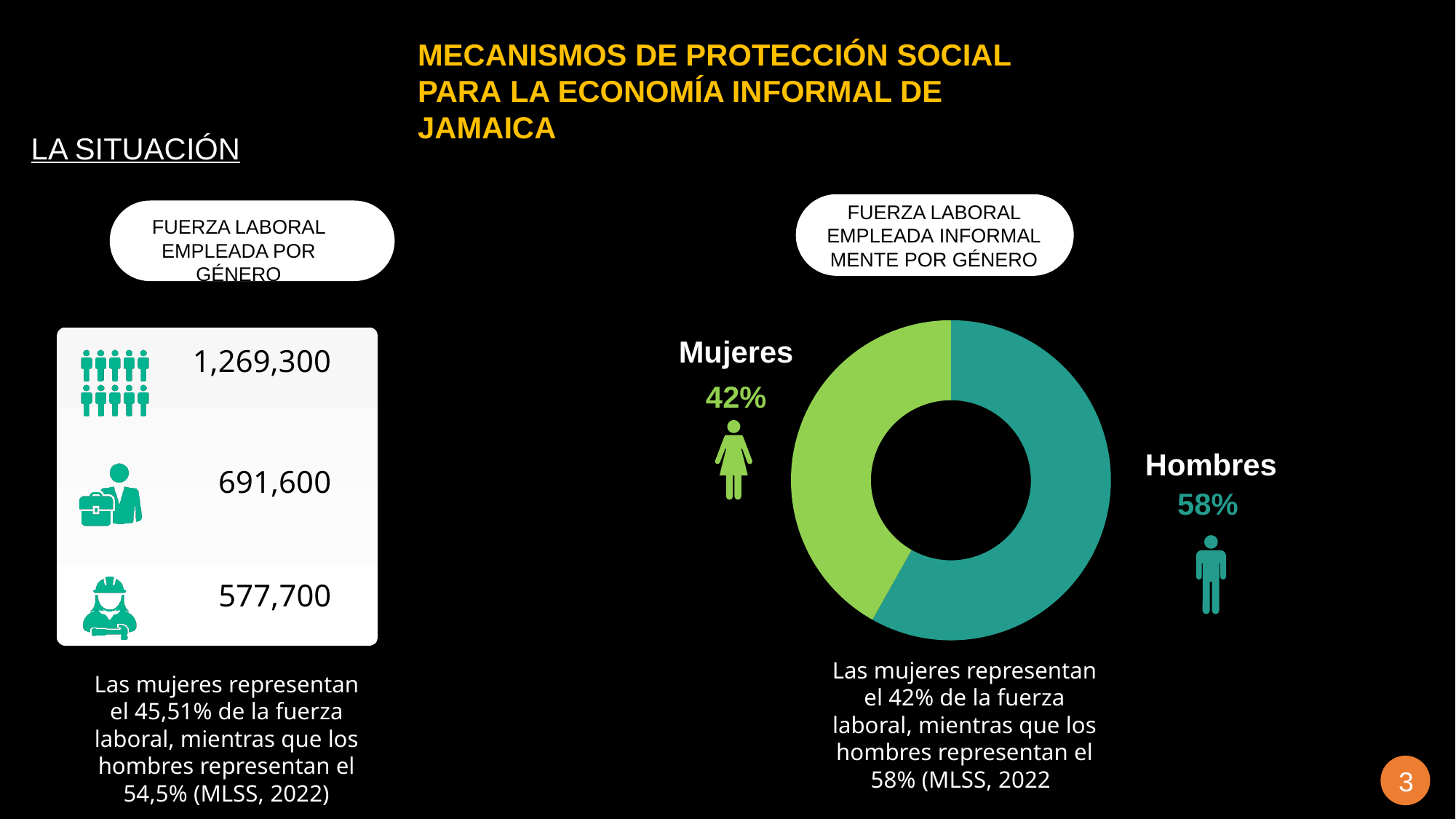
Is the share for Hombres in the donut chart greater or less than 50%? greater By how many percentage points does the Hombres share exceed the Mujeres share in the donut chart? 16 percentage points What colour is the Mujeres slice in the donut chart? Light green Which category has the smaller share in the donut chart? Mujeres What kind of chart is used to show the informally employed labour force by gender? Donut (pie) chart In the donut chart, what share of the informally employed labour force is men (Hombres)? 58% In the donut chart, what share of the informally employed labour force is women (Mujeres)? 42% How many categories are shown in the donut chart? 2 What is the title shown above the donut chart? Fuerza laboral empleada informalmente por género Is the share for Hombres larger or smaller than the share for Mujeres in the donut chart? larger Which category has the larger share in the donut chart? Hombres